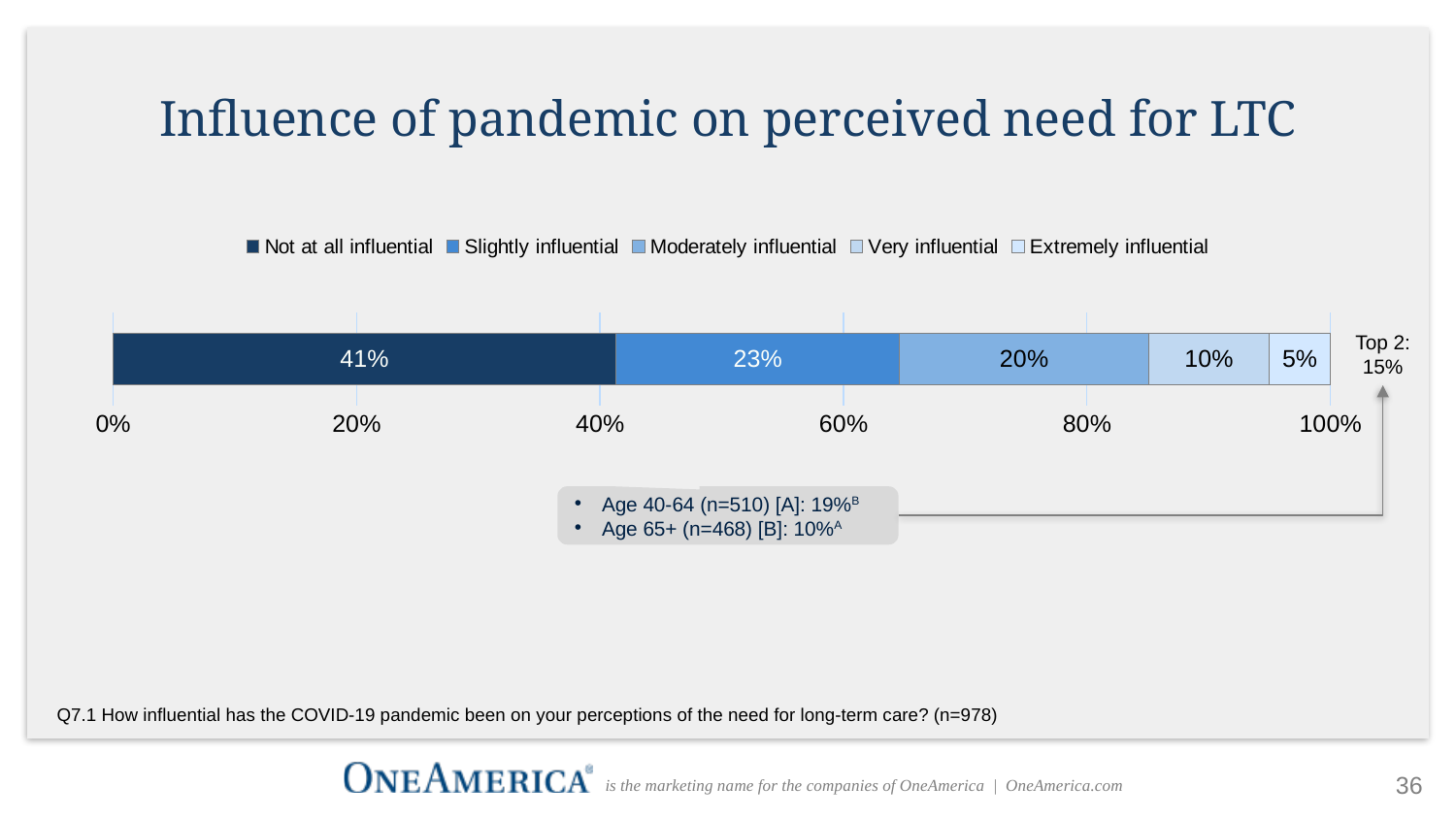
What is the difference between the 'Not at all influential' and 'Slightly influential' shares? 18% What percentage of respondents said the pandemic was extremely influential? 5% What kind of chart is shown on the slide? Stacked bar chart How many series does the legend list? 5 What percentage of respondents said the pandemic was slightly influential? 23% Which response category has the largest share? Not at all influential What is the Top 2 value shown next to the bar? 15% Which is larger, the 'Moderately influential' share or the 'Very influential' share? Moderately influential What percentage of respondents said the pandemic was not at all influential? 41% What percentage of respondents said the pandemic was moderately influential? 20% Which response category has the smallest share? Extremely influential What percentage of respondents said the pandemic was very influential? 10%